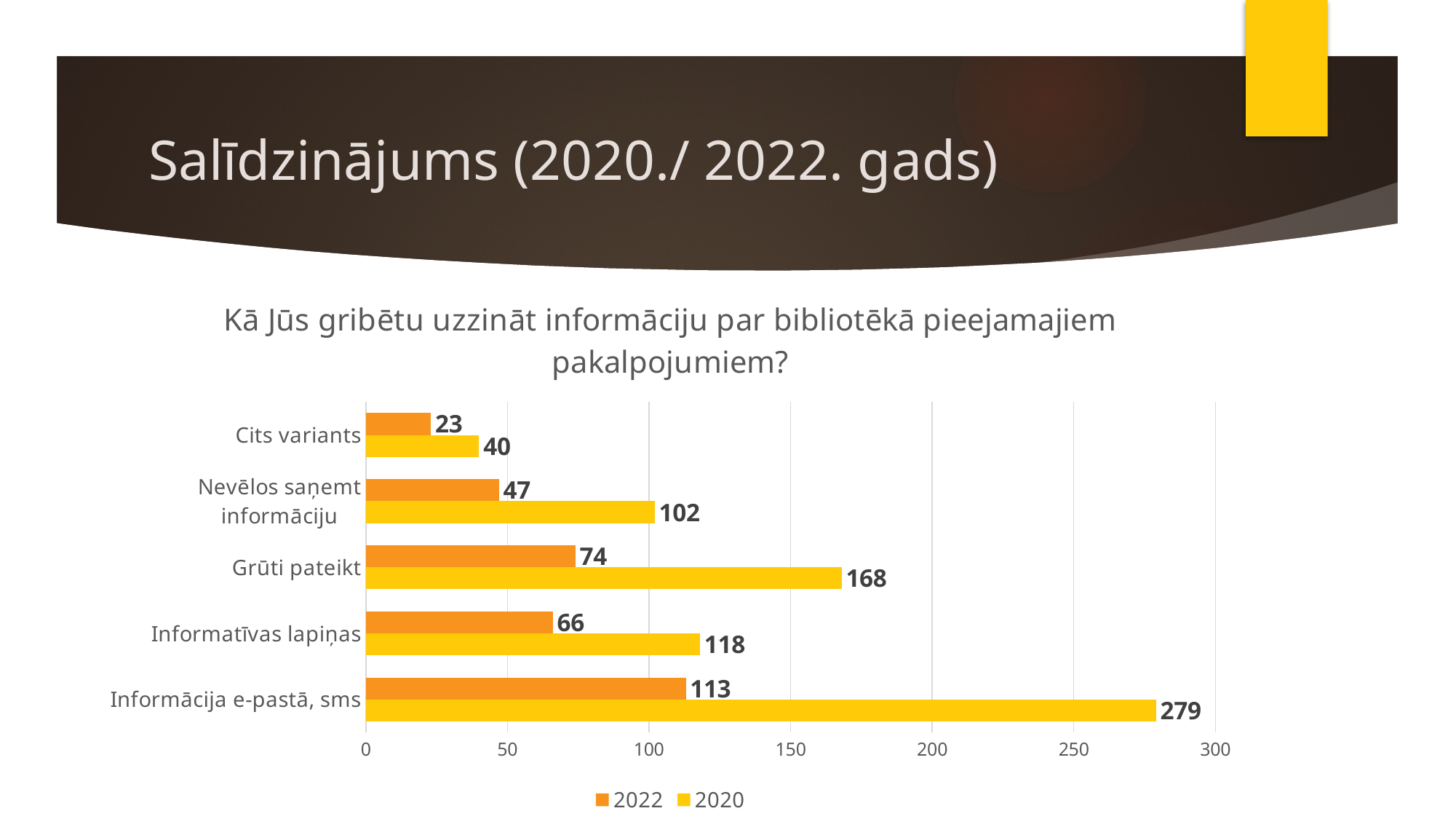
Which category has the lowest 2022 value? Cits variants How many series does the legend list? 2 How many categories are shown on the chart? 5 What is the difference between the 2020 and 2022 values for Informatīvas lapiņas? 52 Which is larger for Grūti pateikt: the 2020 value or the 2022 value? 2020 What is the 2020 value for Informācija e-pastā, sms? 279 What is the 2022 value for Grūti pateikt? 74 What is the 2020 value for Nevēlos saņemt informāciju? 102 What is the difference between the 2020 and 2022 values for Informācija e-pastā, sms? 166 Which category has the highest 2020 value? Informācija e-pastā, sms What kind of chart is shown on the slide? Bar chart Which series is shown in yellow in the legend? 2020